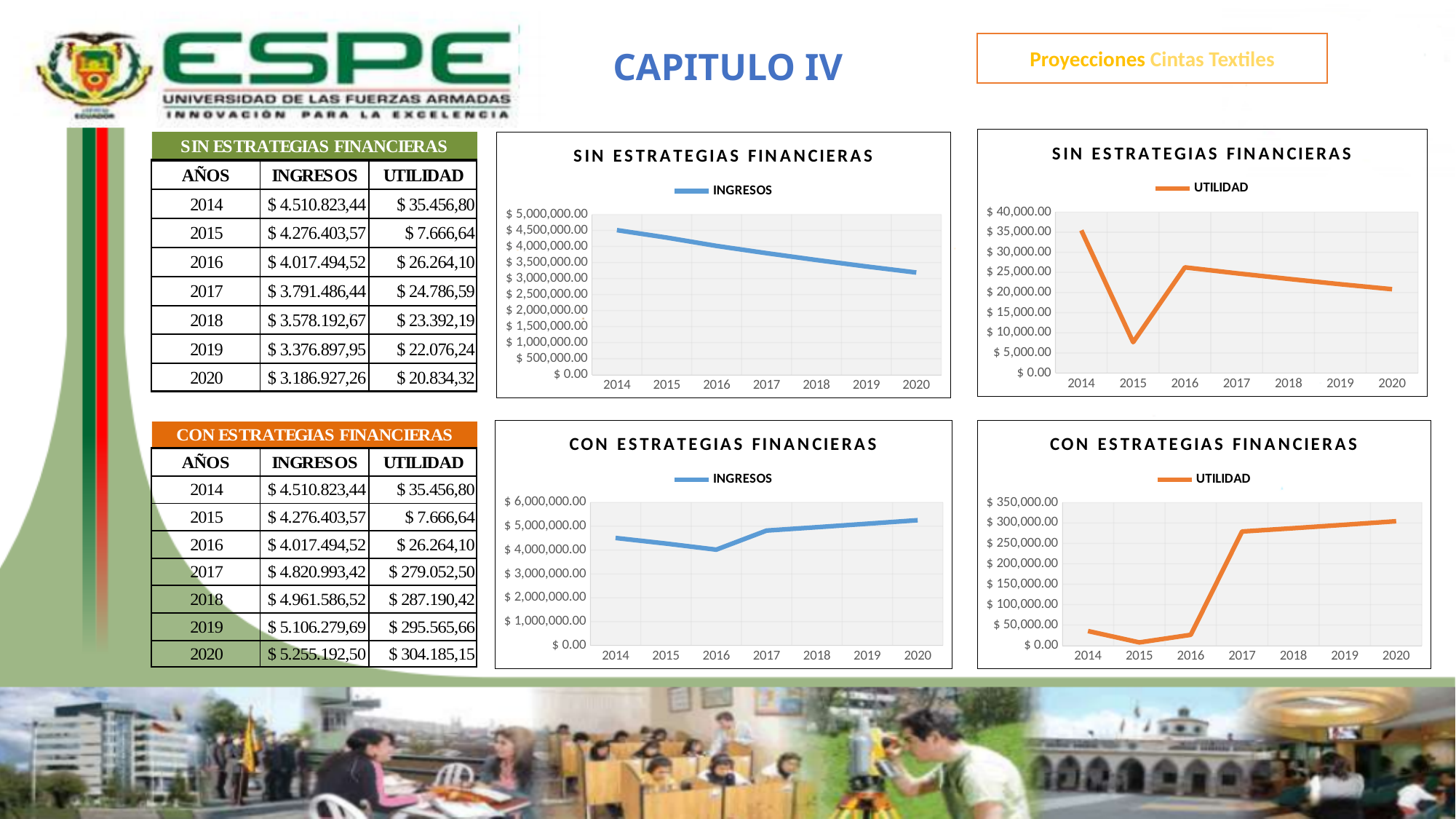
How many years are shown on the x axis of the top-middle 'SIN ESTRATEGIAS FINANCIERAS' INGRESOS chart? 7 In the top-right 'SIN ESTRATEGIAS FINANCIERAS' UTILIDAD chart, which year has the lowest value? 2015 In the bottom-right 'CON ESTRATEGIAS FINANCIERAS' UTILIDAD chart, which year has the highest value? 2020 In the top-right 'SIN ESTRATEGIAS FINANCIERAS' UTILIDAD chart, which year has the highest value? 2014 What kind of chart is the top-middle 'SIN ESTRATEGIAS FINANCIERAS' INGRESOS chart? Line chart In the top-right 'SIN ESTRATEGIAS FINANCIERAS' UTILIDAD chart, is the value for 2015 greater or less than $ 10,000.00? less In the top-middle 'SIN ESTRATEGIAS FINANCIERAS' INGRESOS chart, do the values rise or fall from 2014 to 2020? Fall In the top-middle 'SIN ESTRATEGIAS FINANCIERAS' INGRESOS chart, is the value for 2020 greater or less than $ 3,500,000.00? less How many series does the legend of the bottom-right 'CON ESTRATEGIAS FINANCIERAS' UTILIDAD chart list? 1 What colour is the UTILIDAD line in the top-right 'SIN ESTRATEGIAS FINANCIERAS' chart? Orange In the bottom-middle 'CON ESTRATEGIAS FINANCIERAS' INGRESOS chart, is the value for 2020 greater or less than $ 5,000,000.00? greater In the bottom-right 'CON ESTRATEGIAS FINANCIERAS' UTILIDAD chart, which is larger, the value for 2016 or the value for 2017? 2017